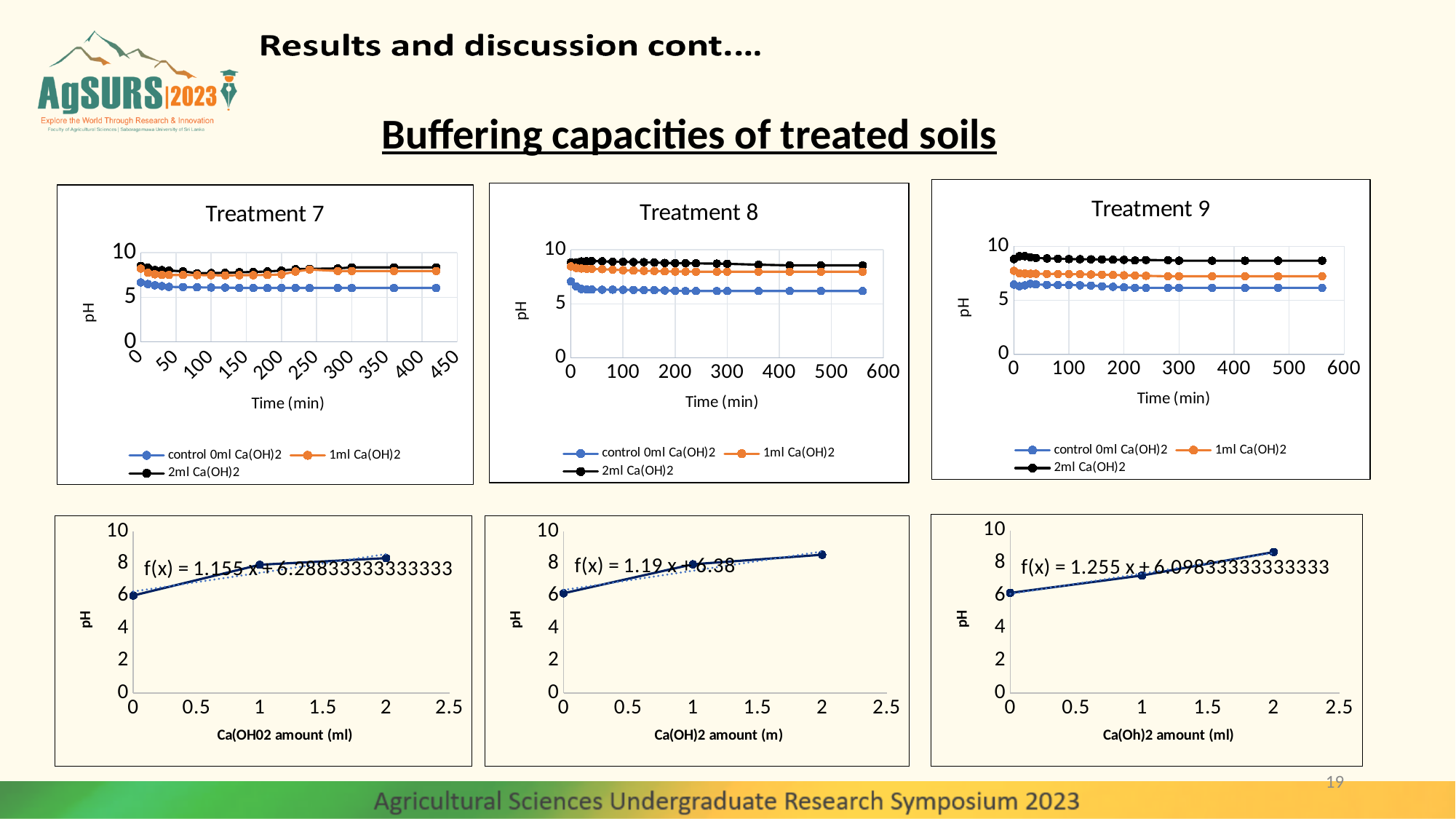
In the Treatment 9 chart, which series has the highest pH values? 2ml Ca(OH)2 In the Treatment 8 chart, which series has higher pH values, 1ml Ca(OH)2 or 2ml Ca(OH)2? 2ml Ca(OH)2 What kind of chart is the Treatment 8 chart? line chart In the Treatment 9 chart, which series has the lowest pH values? control 0ml Ca(OH)2 In the Treatment 7 chart, how many series does the legend list? 3 What is the trendline equation shown on the bottom-middle chart? f(x) = 1.19 x + 6.38 How many data points are plotted in the bottom-middle chart? 3 What is the slope of the trendline in the bottom-right chart? 1.255 In the Treatment 8 chart, is the pH of the control 0ml Ca(OH)2 series at 0 min greater or less than 5? greater In the bottom-right chart, does pH rise or fall as the Ca(OH)2 amount increases? rises In the Treatment 9 chart, is the pH of the 2ml Ca(OH)2 series greater or less than 10? less What is the trendline equation shown on the bottom-left chart? f(x) = 1.155 x + 6.28833333333333